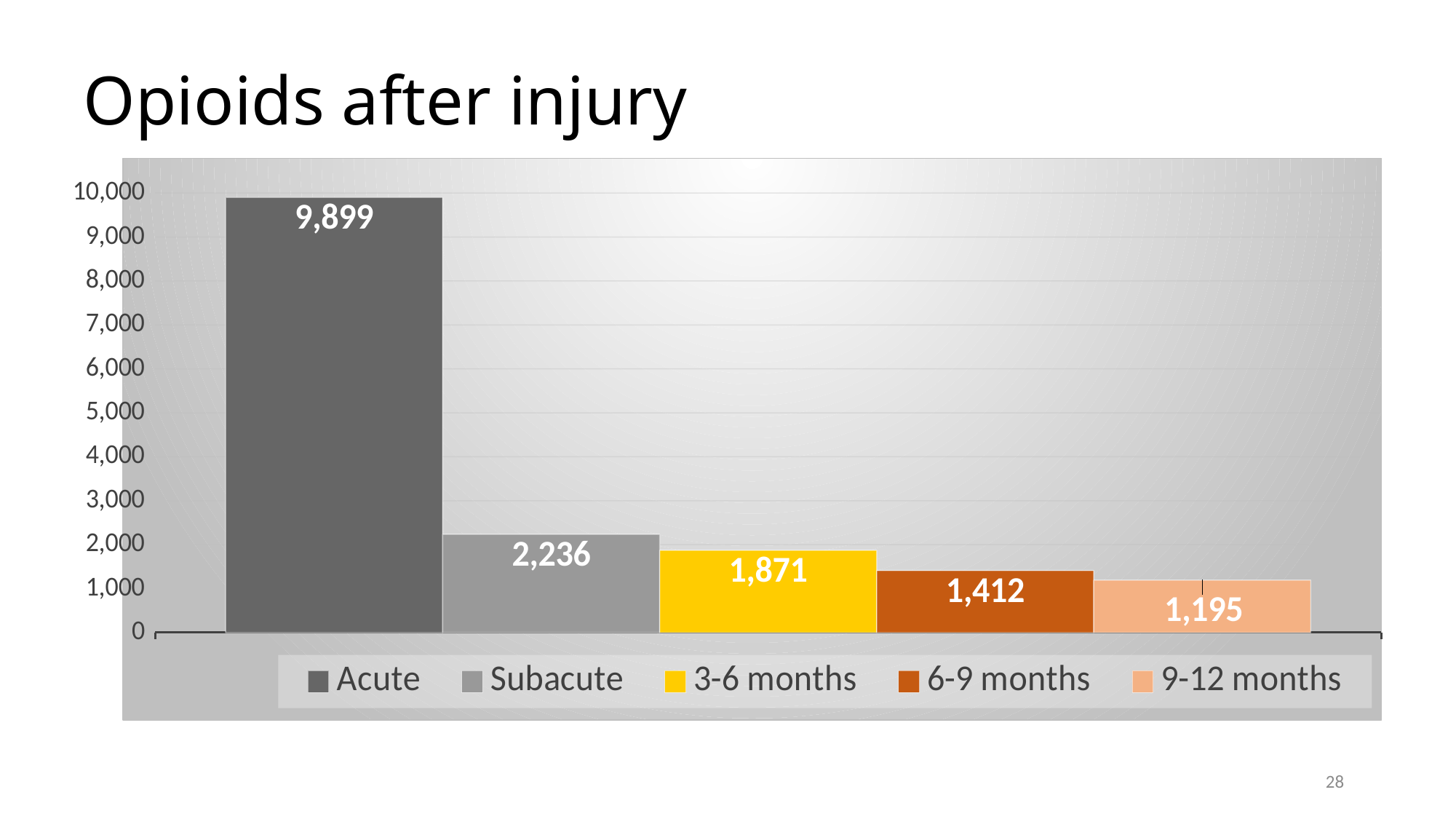
Which is larger, the value for 3-6 months or the value for 6-9 months? 3-6 months What is the value for 3-6 months? 1,871 Do the values rise or fall from left to right across the chart? Fall Which category has the highest value? Acute How many categories are shown in the chart? 5 What is the value for 9-12 months? 1,195 Which category has the lowest value? 9-12 months What is the difference between the 6-9 months and 9-12 months values? 217 What kind of chart is shown on the slide? Bar chart What is the value for Subacute? 2,236 What is the difference between the Acute and Subacute values? 7,663 What is the value for Acute? 9,899